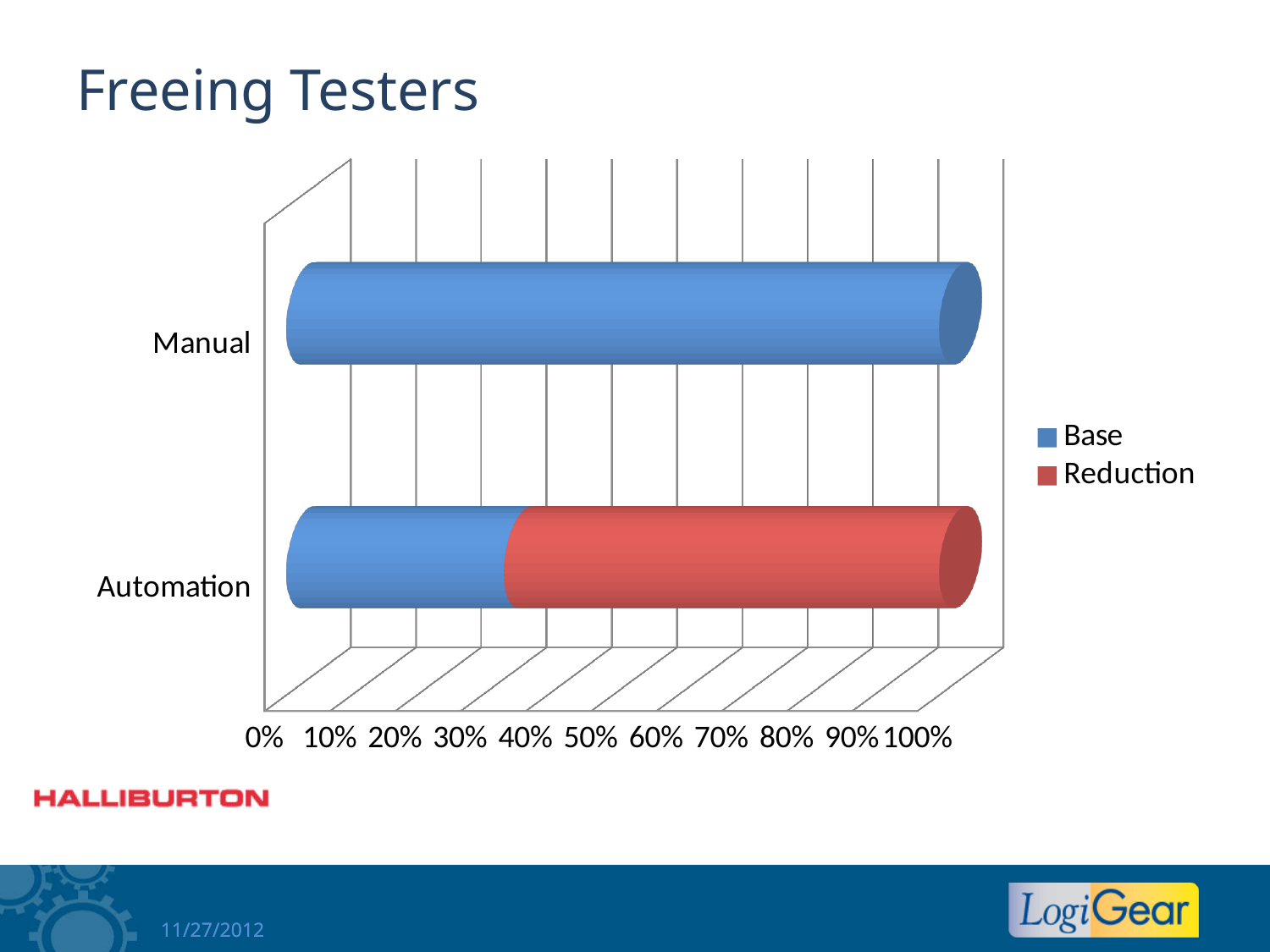
How many categories are shown on the chart? 2 For the Automation bar, which segment is larger, Base or Reduction? Reduction What kind of chart is shown on the slide? Bar chart Is the Base value for Automation greater or less than 20%? greater Which colour represents the Reduction series? Red How many series does the legend list? 2 Is the Base value for Automation greater or less than 50%? less Which category has the larger Base value, Manual or Automation? Manual Is the Base value for Manual greater or less than 90%? greater Which category has the highest Base value? Manual What are the series names listed in the legend? Base, Reduction